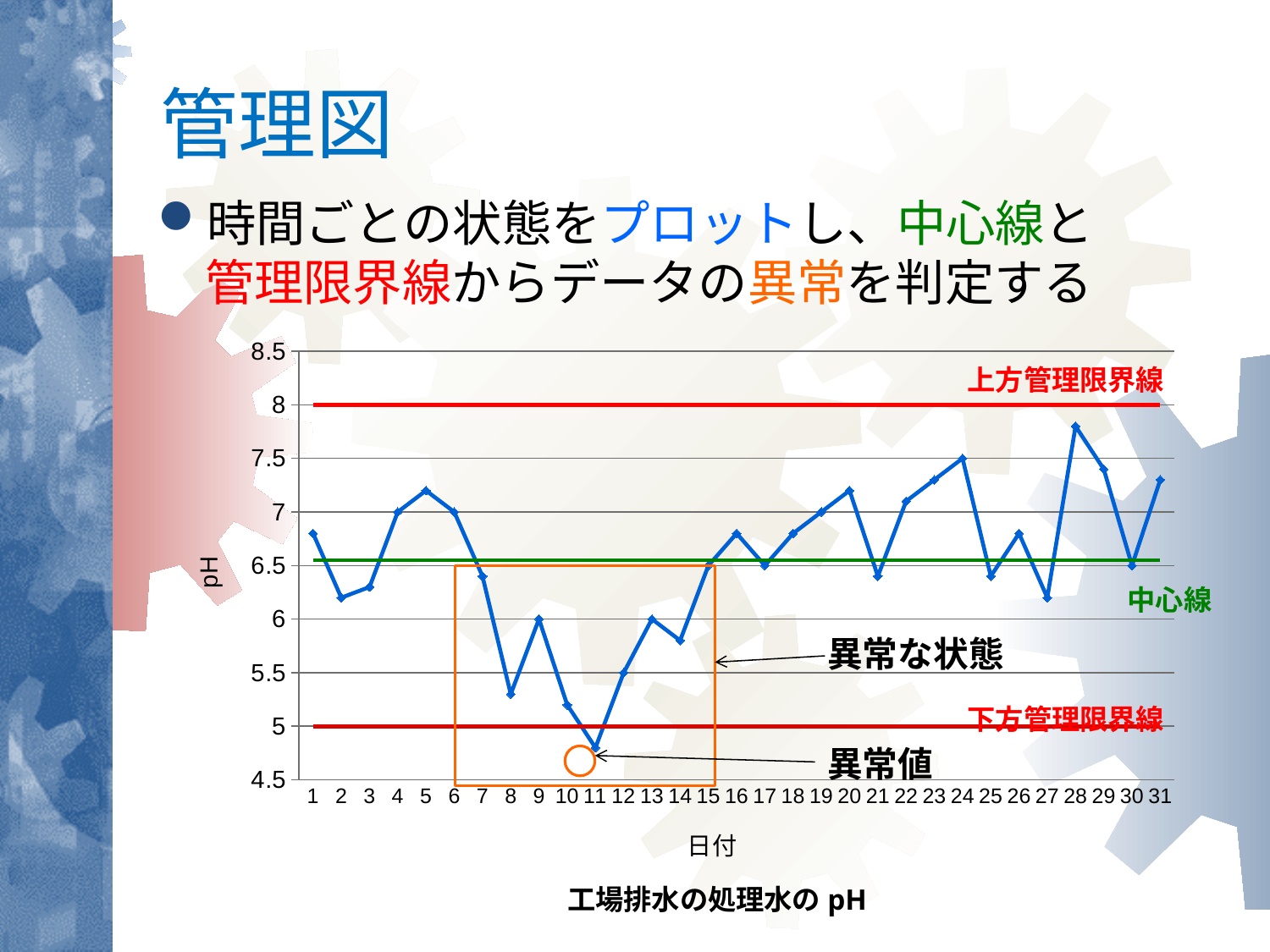
On which date is the pH value the lowest? 11 At what pH value is the upper control limit line (上方管理限界線) drawn? 8 What is the title shown below the chart? 工場排水の処理水の pH How many dates (data points) are plotted along the x axis? 31 Is the pH value on date 11 greater or less than 5? less On which date is the pH value the highest? 28 At what pH value is the lower control limit line (下方管理限界線) drawn? 5 What is the label of the y axis? pH Do the pH values rise or fall from date 6 to date 11? fall Which date has the higher pH value, date 8 or date 24? 24 Is the pH value on date 28 greater or less than 7.5? greater What kind of chart is shown on the slide? line chart